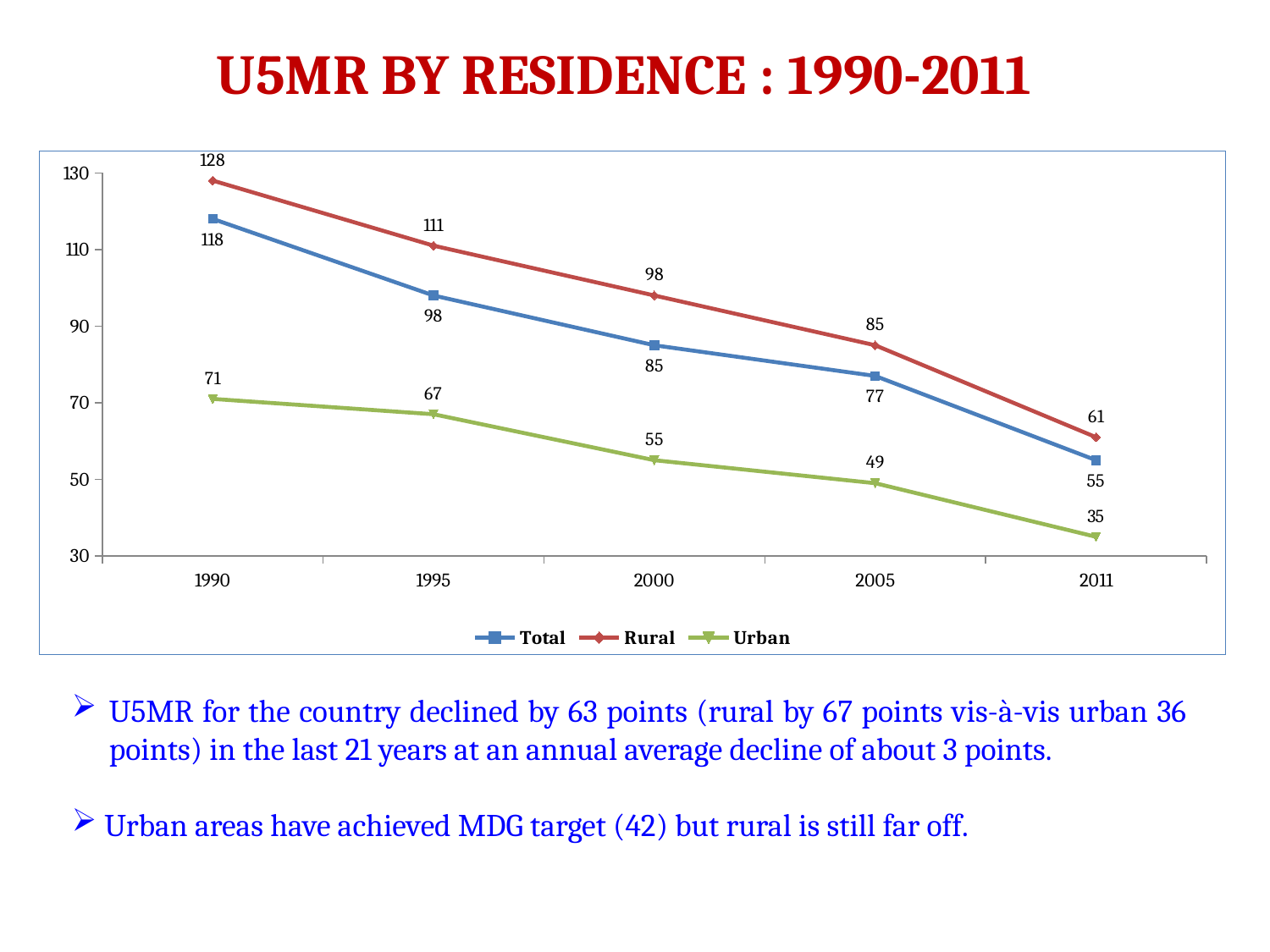
In which year is the Total series at its highest? 1990 In which year is the Urban series at its lowest? 2011 By how much did the Total value decline from 1990 to 2011? 63 What is the Rural U5MR value in 1990? 128 How many series does the legend list? 3 How many years are shown on the x axis? 5 Do the Rural values rise or fall from 1990 to 2011? Fall What is the Urban U5MR value in 2011? 35 What kind of chart is shown on the slide? Line chart Which is larger in 1995, the Rural value or the Total value? Rural What is the difference between the Rural and Urban values in 2005? 36 What is the Total U5MR value in 2000? 85